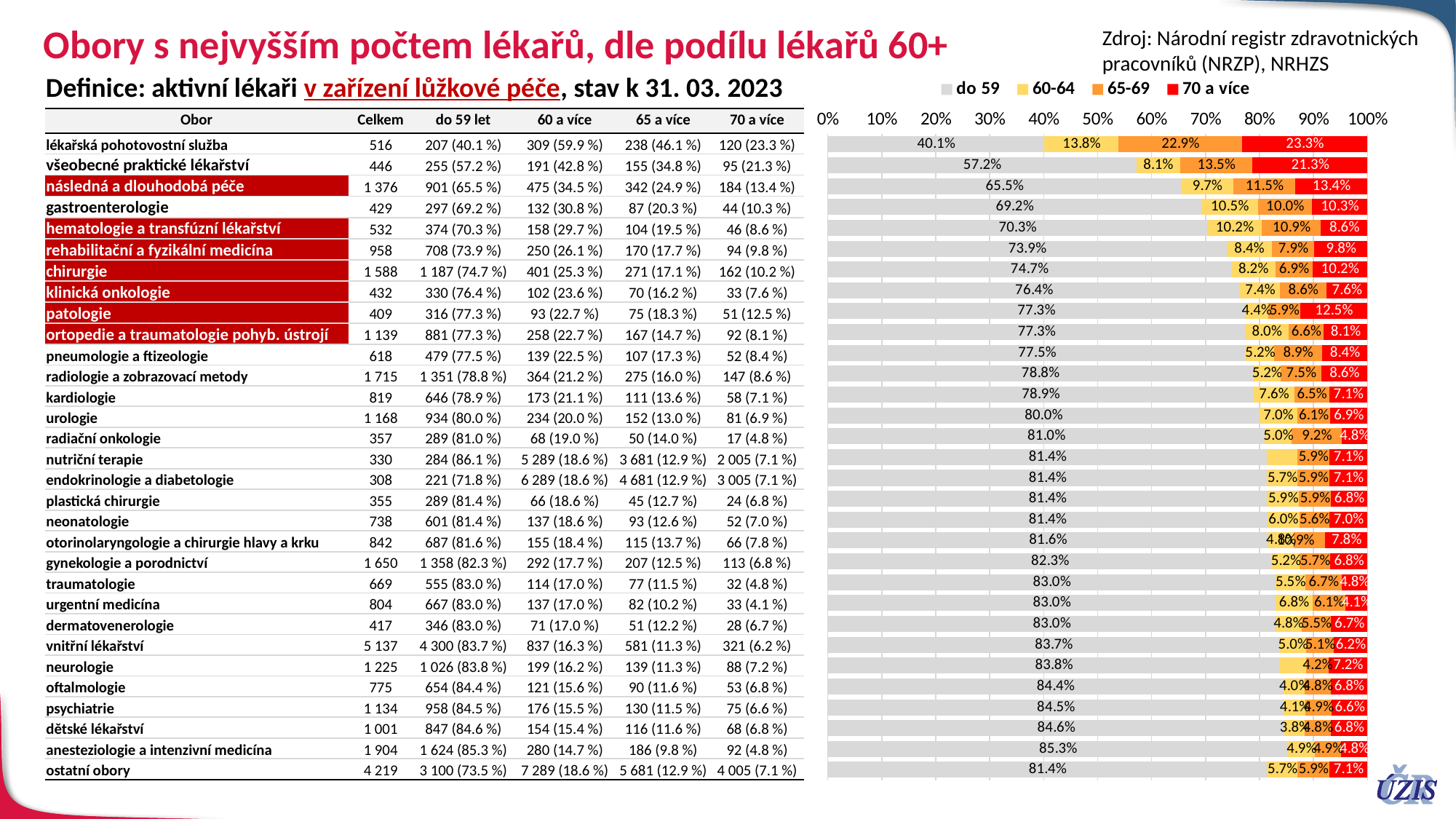
In the chart, what is the '70 a více' value for the top bar (lékařská pohotovostní služba)? 23.3% What kind of chart is shown on the right side of the slide? bar chart In the chart, is the '65-69' segment larger for the top bar (lékařská pohotovostní služba) or the second bar (všeobecné praktické lékařství)? the top bar (lékařská pohotovostní služba) Which bar in the chart has the largest '70 a více' segment? the top bar (lékařská pohotovostní služba), 23.3% Which bar in the chart has the smallest 'do 59' segment? the top bar (lékařská pohotovostní služba), 40.1% How many bars does the chart contain? 31 In the chart, what is the '65-69' value for the third bar (následná a dlouhodobá péče)? 11.5% In the chart, what is the 'do 59' value for the first (top) bar, corresponding to lékařská pohotovostní služba? 40.1% In the chart, what is the '60-64' value for the second bar (všeobecné praktické lékařství)? 8.1% How many series does the chart legend list? 4 What are the four legend entries of the chart? do 59, 60-64, 65-69, 70 a více In the chart, what is the difference between the '70 a více' values of the top bar (23.3%) and the second bar (21.3%)? 2.0%